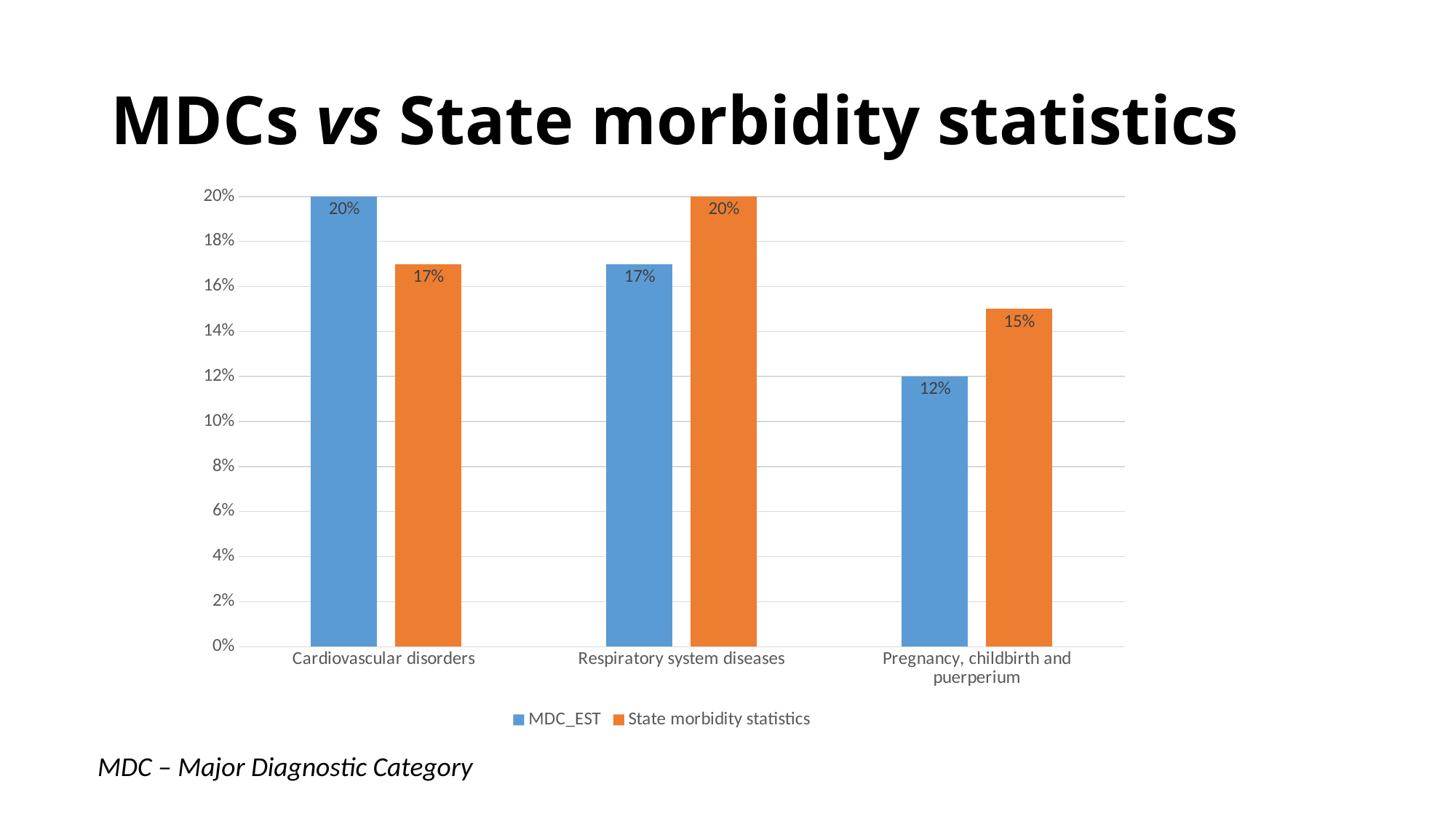
What is the difference between the MDC_EST and State morbidity statistics values for Cardiovascular disorders? 3% What is the State morbidity statistics value for Pregnancy, childbirth and puerperium? 15% What is the State morbidity statistics value for Respiratory system diseases? 20% Which category has the lowest MDC_EST value? Pregnancy, childbirth and puerperium What is the difference between the State morbidity statistics and MDC_EST values for Pregnancy, childbirth and puerperium? 3% What kind of chart is shown on the slide? Bar chart How many categories are shown on the x axis? 3 What is the MDC_EST value for Pregnancy, childbirth and puerperium? 12% For Respiratory system diseases, which is larger: MDC_EST or State morbidity statistics? State morbidity statistics Which category has the highest State morbidity statistics value? Respiratory system diseases How many series does the legend list? 2 What is the MDC_EST value for Cardiovascular disorders? 20%